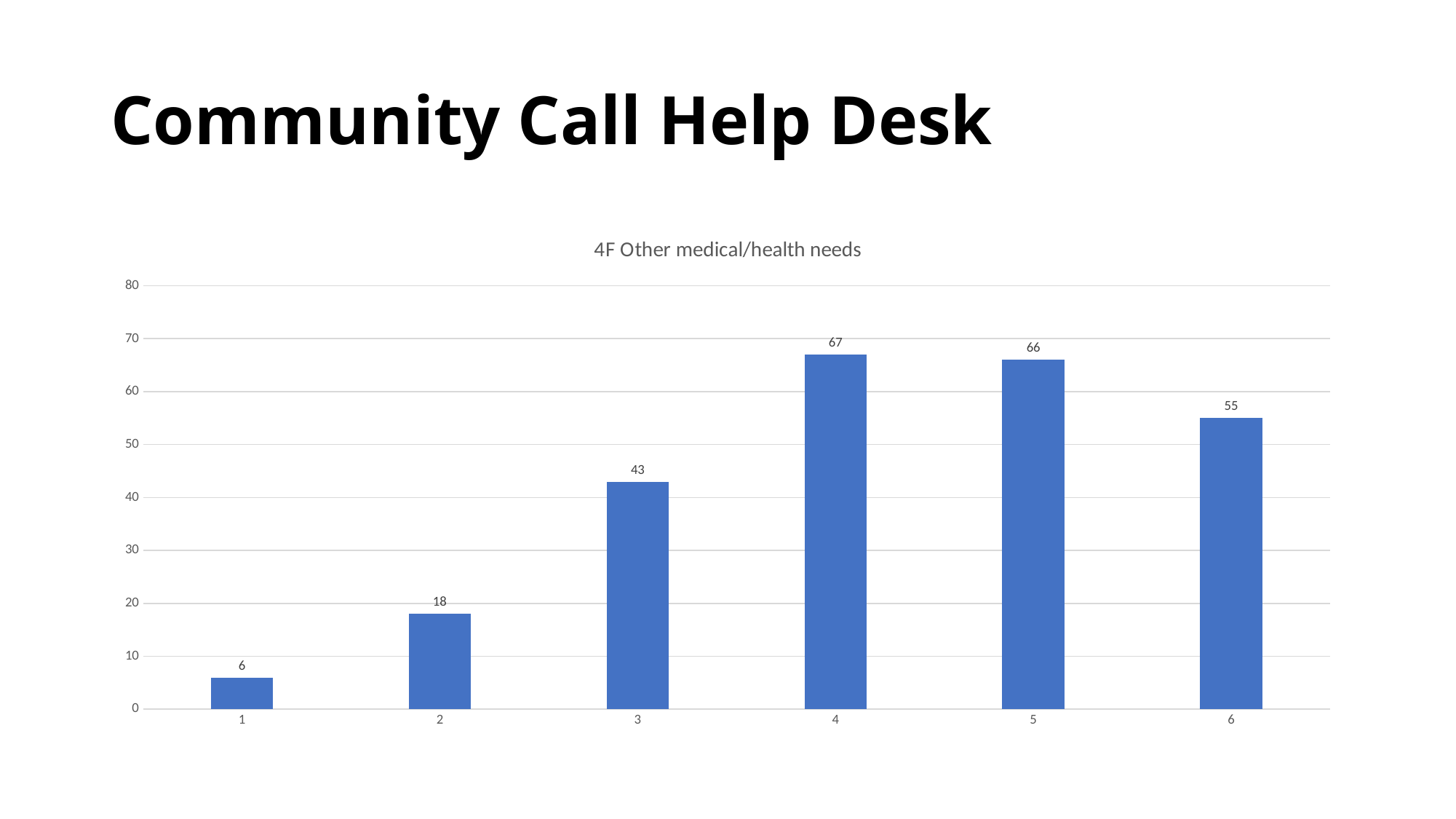
Which is larger, the value for category 3 or the value for category 6? category 6 What is the title of the chart? 4F Other medical/health needs What is the difference between the values for category 4 and category 2? 49 How many categories are shown on the x axis? 6 Is the value for category 5 greater or less than 60? greater What is the value for category 1? 6 What kind of chart is shown? bar chart What is the value for category 3? 43 Which category has the highest value? 4 Which category has the lowest value? 1 Do the values rise or fall from category 1 to category 4? rise What is the value for category 6? 55